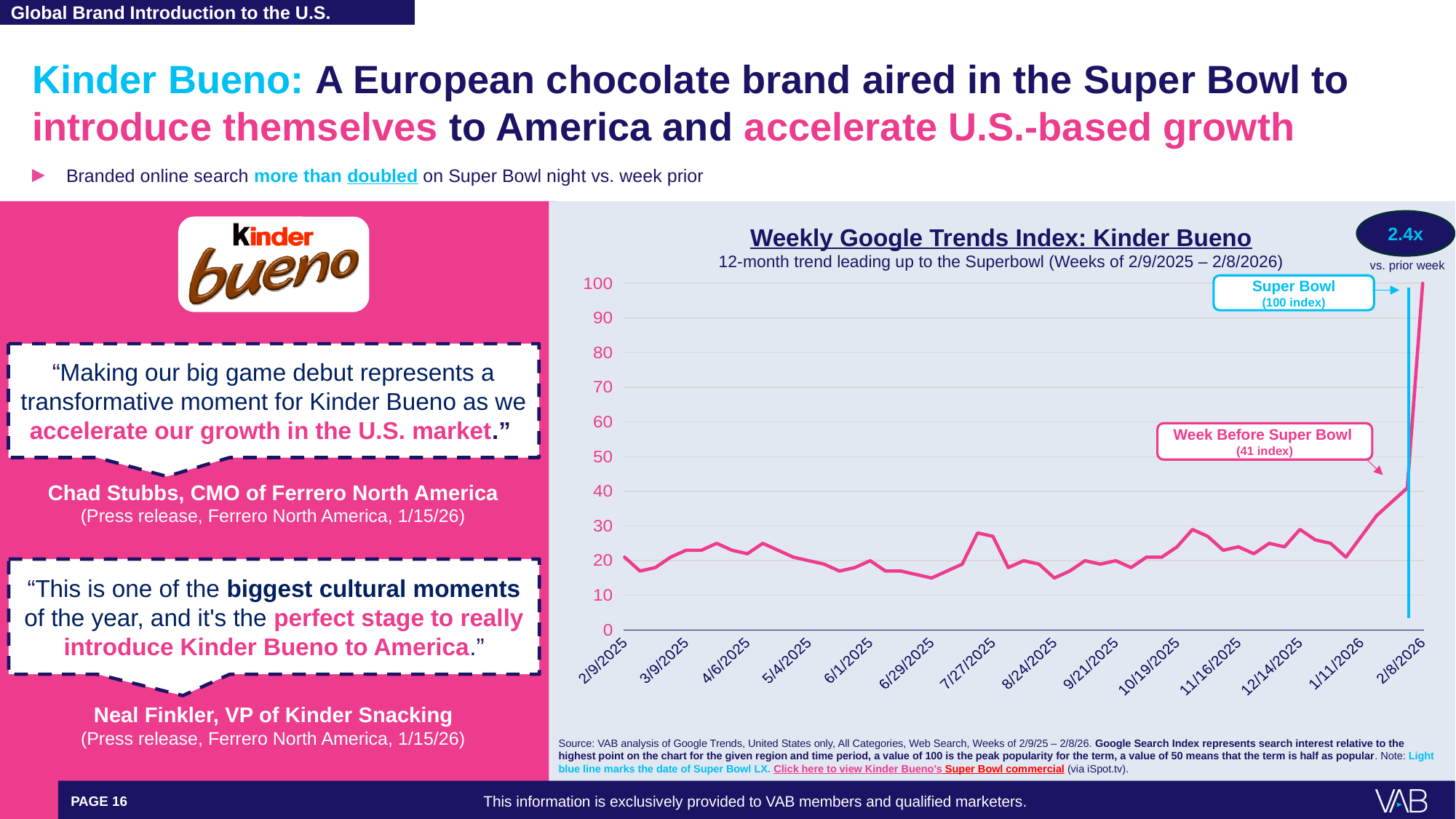
What is the difference between the Super Bowl week index and the week-before index? 59 According to the callout on the chart, by how much did the Super Bowl week index increase vs. the prior week? 2.4x Is the index value for 12/14/2025 greater or less than 40? less How many date labels are shown on the x axis of the chart? 14 Which is larger: the index for the Super Bowl week or the index for the week before the Super Bowl? Super Bowl week Which week has the highest Google Trends index value on the chart? Super Bowl week (2/8/2026) Is the index value for 2/9/2025 greater or less than 30? less What kind of chart is shown on the slide? Line chart Does the Google Trends index rise or fall from the start of the chart to the end? Rises What is the Google Trends index value for the Super Bowl week? 100 Is the index value for 9/21/2025 greater or less than 30? less What is the Google Trends index value for the week before the Super Bowl? 41